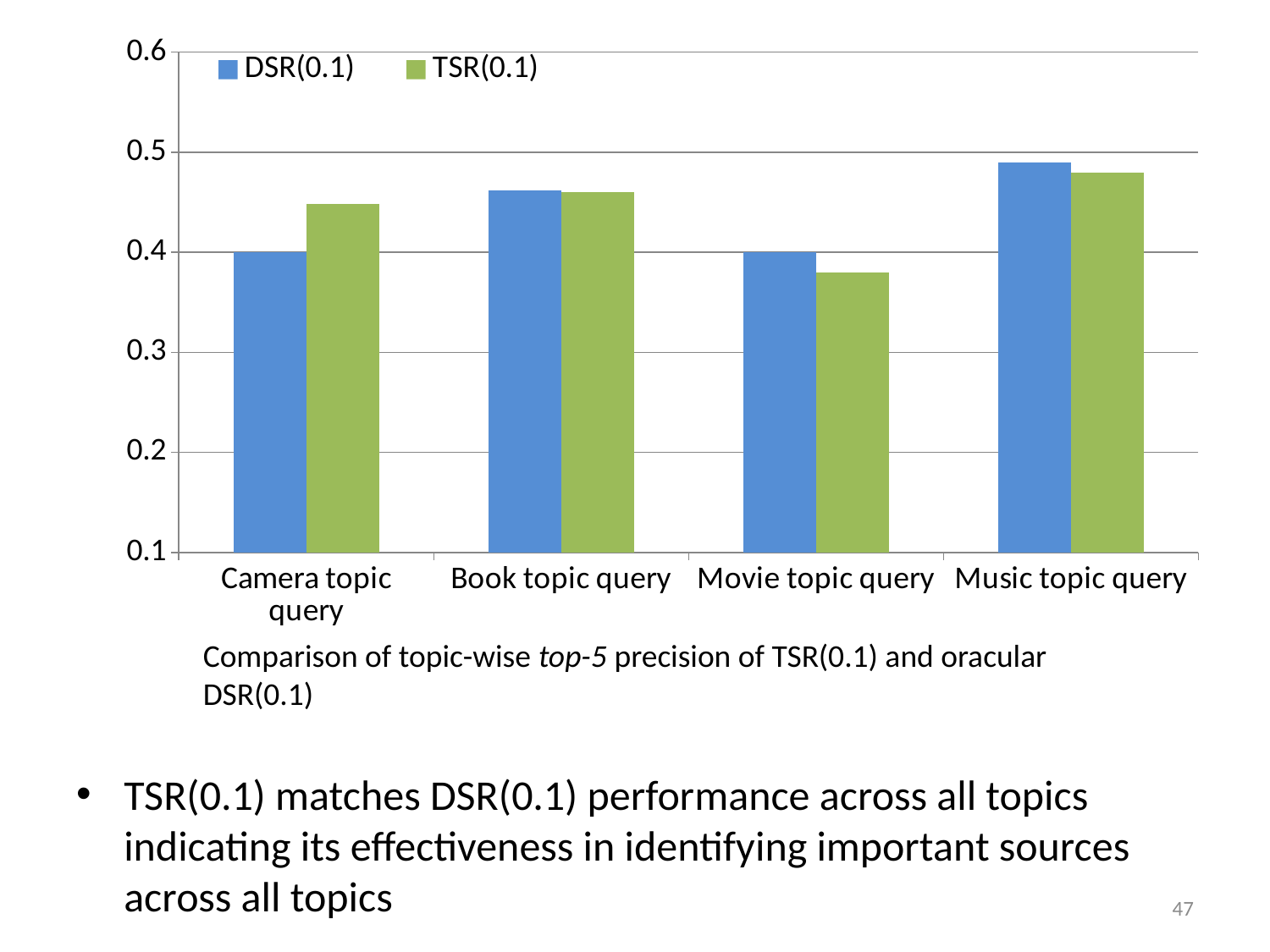
Is the TSR(0.1) value for Movie topic query greater or less than 0.4? less What kind of chart is shown on the slide? bar chart What is the DSR(0.1) value for Camera topic query? 0.4 Is the DSR(0.1) value for Music topic query greater or less than 0.5? less Which topic query has the lowest TSR(0.1) value? Movie topic query How many series does the legend list? 2 What is the DSR(0.1) value for Movie topic query? 0.4 For Camera topic query, which is larger, DSR(0.1) or TSR(0.1)? TSR(0.1) How many topic query categories are shown on the x axis? 4 Is the TSR(0.1) value for Camera topic query greater or less than 0.4? greater For Movie topic query, which is larger, DSR(0.1) or TSR(0.1)? DSR(0.1) Which topic query has the highest DSR(0.1) value? Music topic query